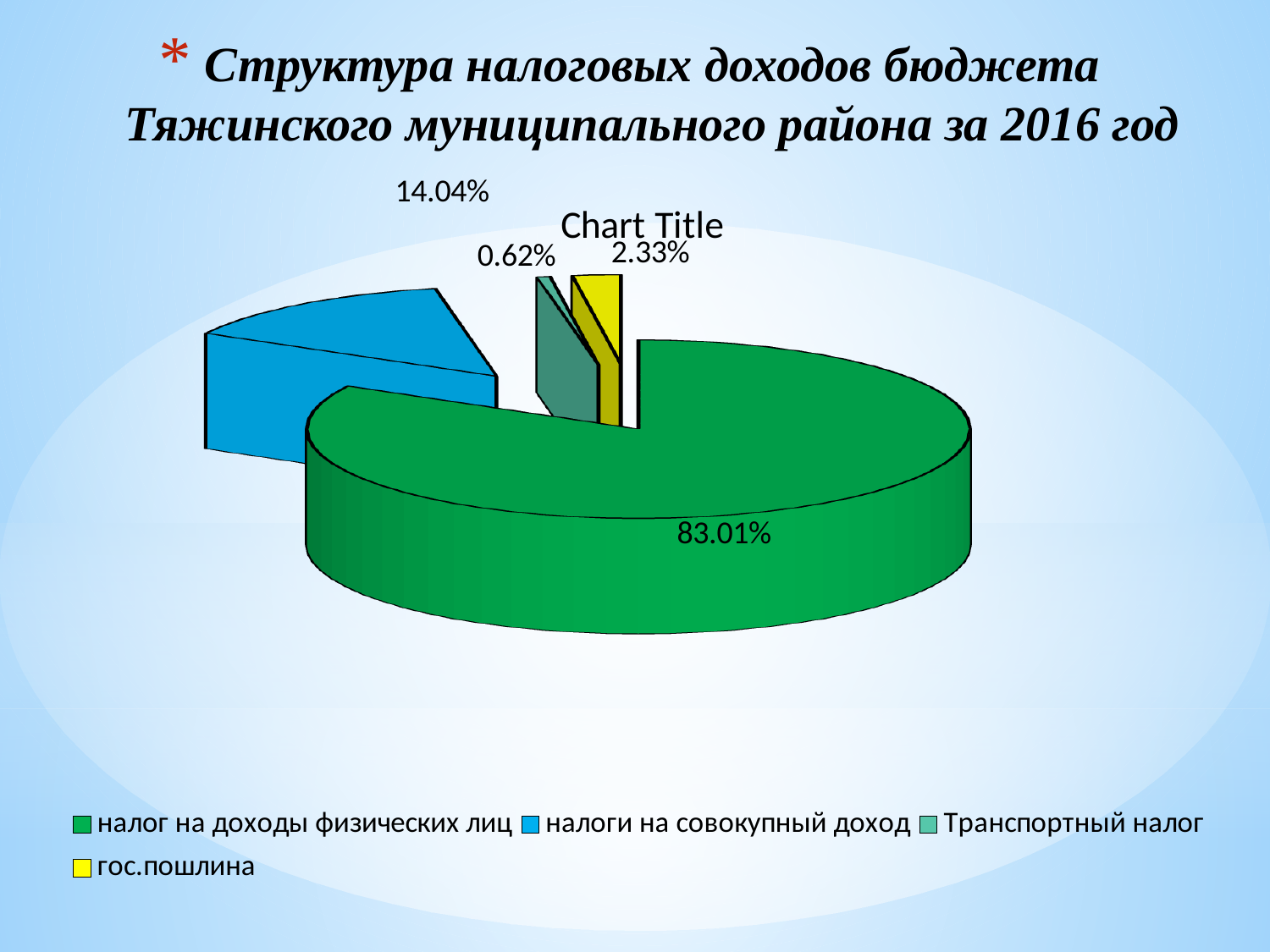
Which category has the largest share of the pie? налог на доходы физических лиц What is the difference between the shares of налог на доходы физических лиц and налоги на совокупный доход? 68.97% What share of the pie does налоги на совокупный доход have? 14.04% What share of the pie does налог на доходы физических лиц have? 83.01% What title is printed above the pie chart itself? Chart Title What share of the pie does гос.пошлина have? 2.33% What colour is the slice for налоги на совокупный доход? blue Which is larger, the share of гос.пошлина or the share of Транспортный налог? гос.пошлина How many slices does the pie chart have? 4 What kind of chart is shown on the slide? pie chart Which category has the smallest share of the pie? Транспортный налог